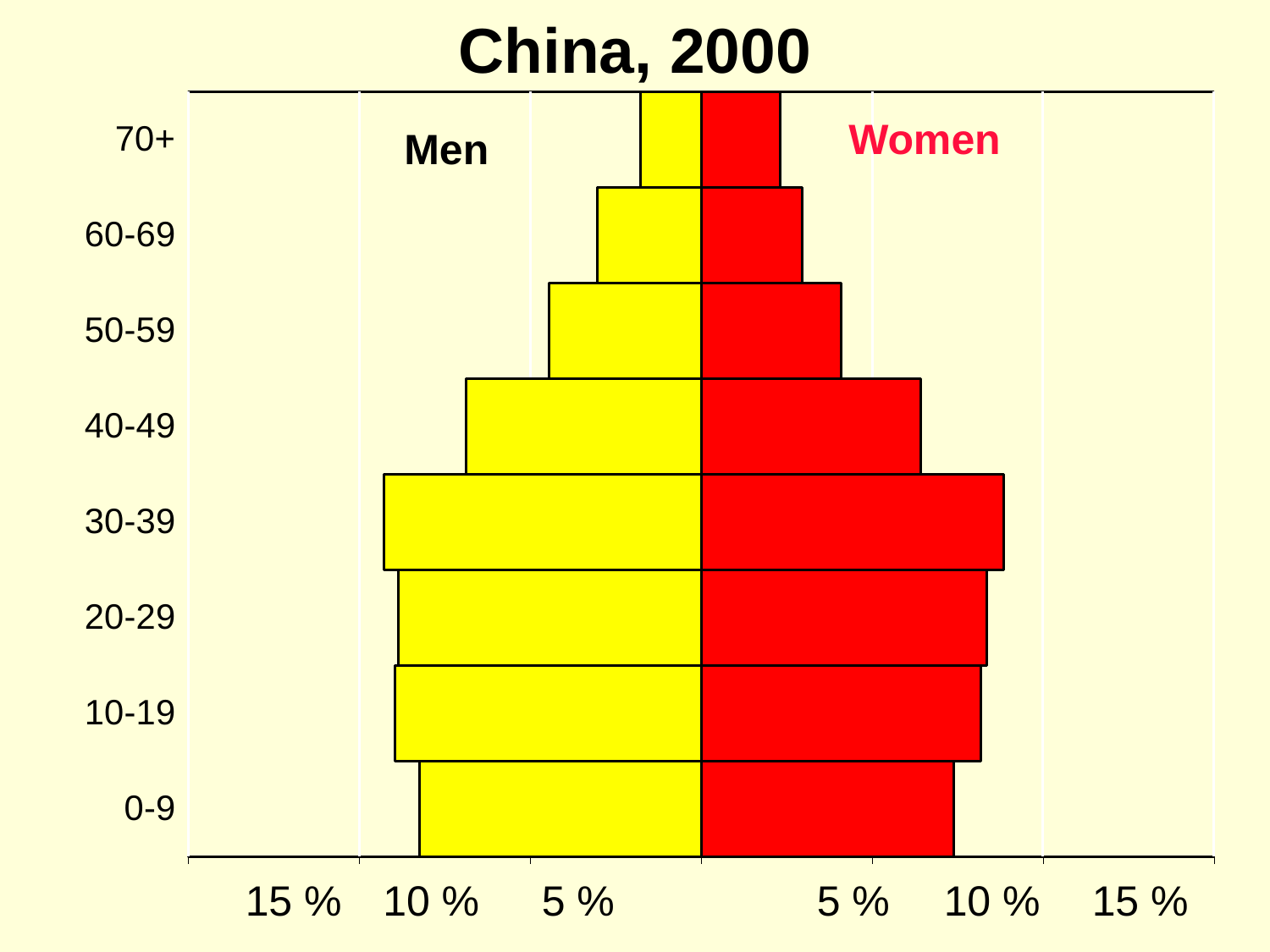
Do the Men's values rise or fall as age increases from 30-39 to 70+? fall Which age group has the largest share for Men? 30-39 What is the title of the chart? China, 2000 Is the value for Women aged 30-39 greater or less than 10 %? less How many age groups are shown on the chart? 8 For the 0-9 age group, which is larger, the Men bar or the Women bar? Men What kind of chart is shown on the slide? bar chart (population pyramid) Which age group has the smallest share for Women? 70+ Which colour represents Women on the chart? red Is the value for Men aged 60-69 greater or less than 5 %? less How many series (population groups) does the chart show? 2 Is the value for Men aged 40-49 greater or less than 5 %? greater